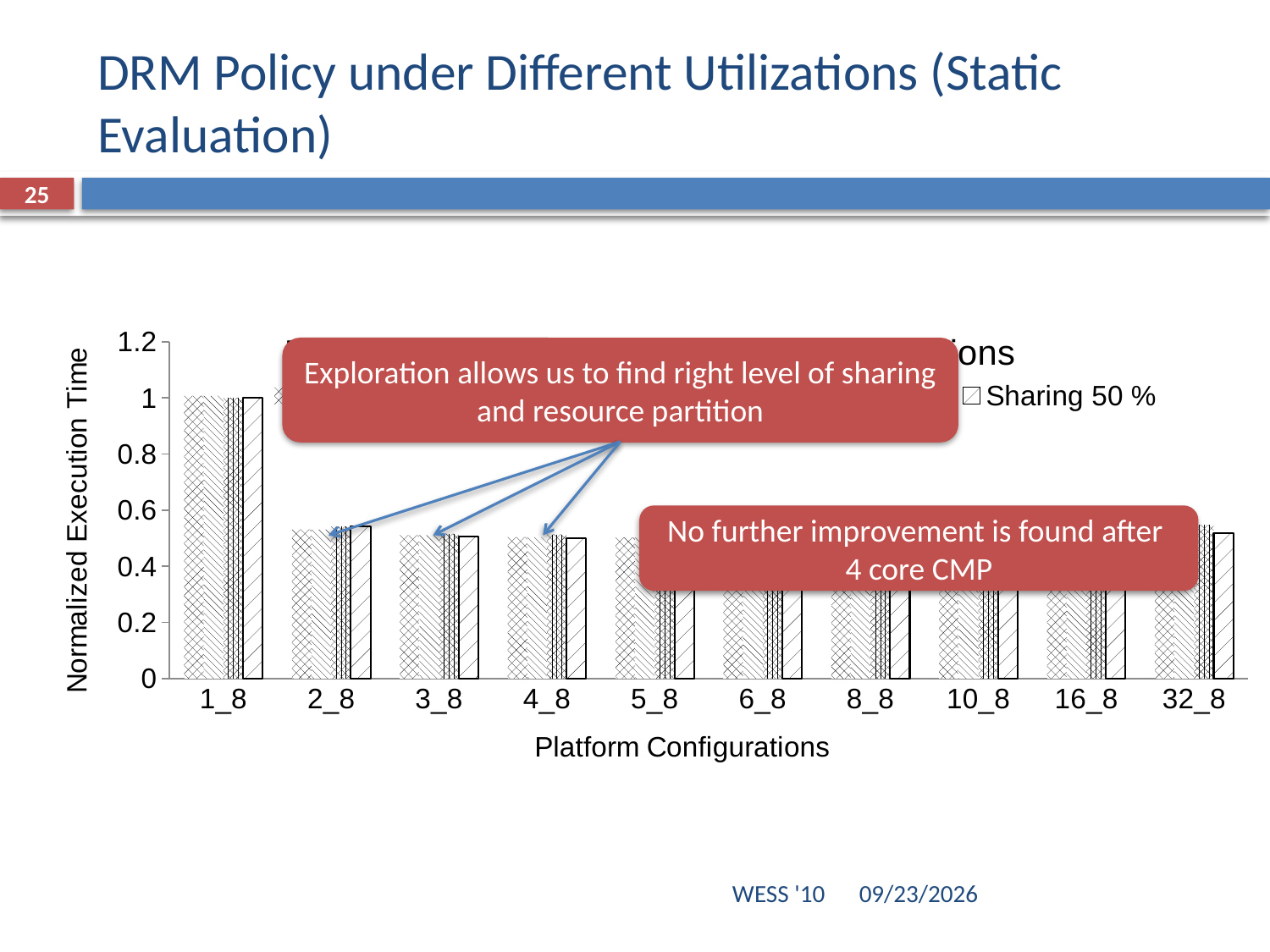
What is the label of the y axis? Normalized Execution Time Is the normalized execution time for configuration 4_8 greater or less than 0.6? less Is the normalized execution time for configuration 1_8 greater or less than 0.8? greater Is the normalized execution time for configuration 32_8 greater or less than 0.8? less What kind of chart is shown on the slide? bar chart What is the label of the x axis? Platform Configurations How many platform configurations are shown on the x axis? 10 What is the normalized execution time for the Sharing 50 % series at configuration 1_8? 1 Which platform configuration has the highest normalized execution time? 1_8 Do the normalized execution time values rise or fall from configuration 1_8 to configuration 2_8? fall Which has the larger normalized execution time, configuration 1_8 or configuration 2_8? 1_8